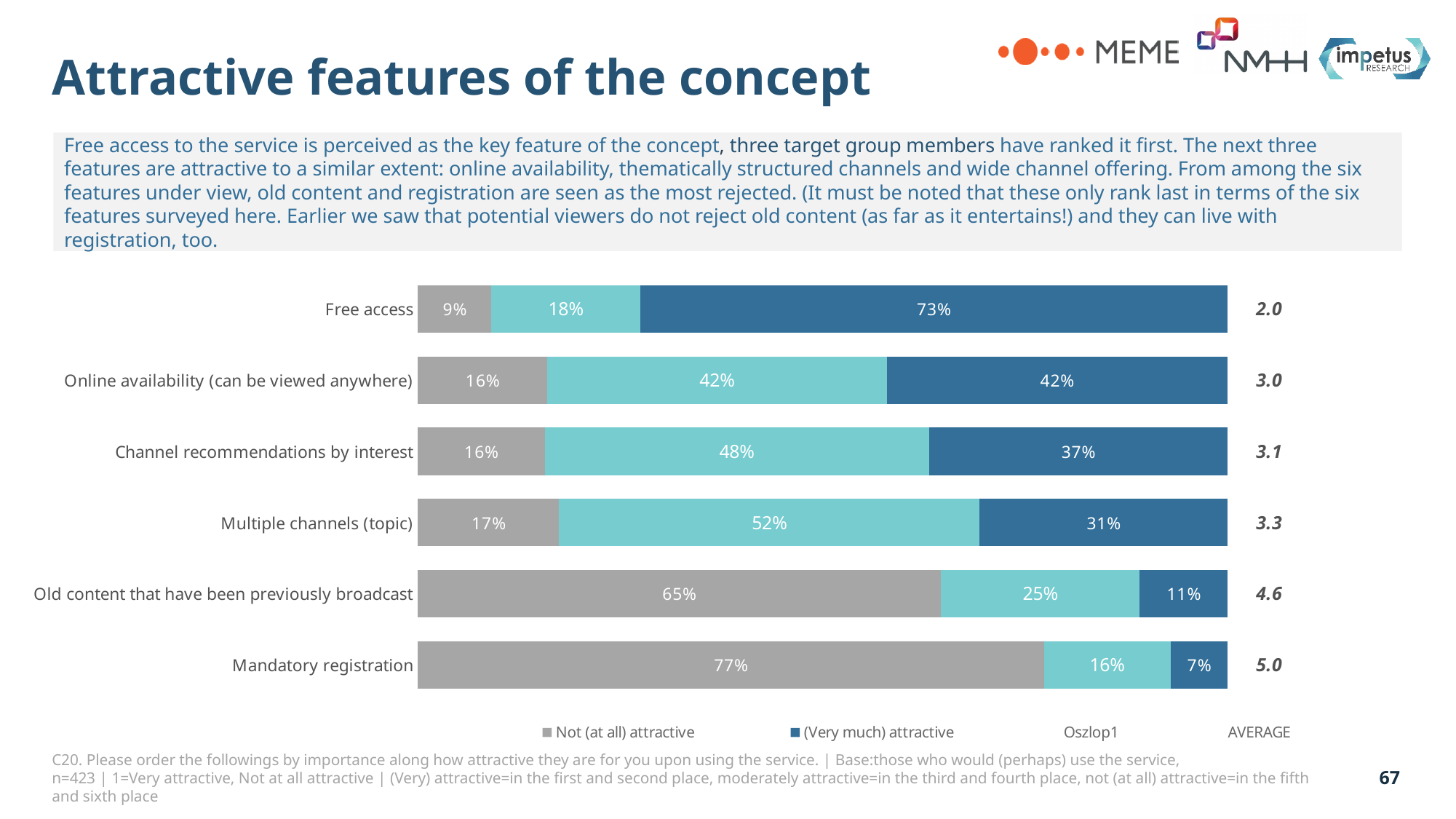
Which feature has the highest (Very much) attractive percentage? Free access What is the total of the three segments in the Free access bar? 100% What is the Not (at all) attractive share for Mandatory registration? 77% What is the difference in the Not (at all) attractive share between Old content that have been previously broadcast and Multiple channels (topic)? 48 percentage points What is the AVERAGE value shown for Old content that have been previously broadcast? 4.6 Which has a larger (Very much) attractive share: Online availability (can be viewed anywhere) or Channel recommendations by interest? Online availability (can be viewed anywhere) What is the Not (at all) attractive share for Online availability (can be viewed anywhere)? 16% What percentage of respondents found Free access (Very much) attractive? 73% Which feature has the highest AVERAGE value? Mandatory registration How many features are listed in the chart? 6 Which feature has the lowest (Very much) attractive percentage? Mandatory registration What type of chart is shown on the slide? Stacked bar chart